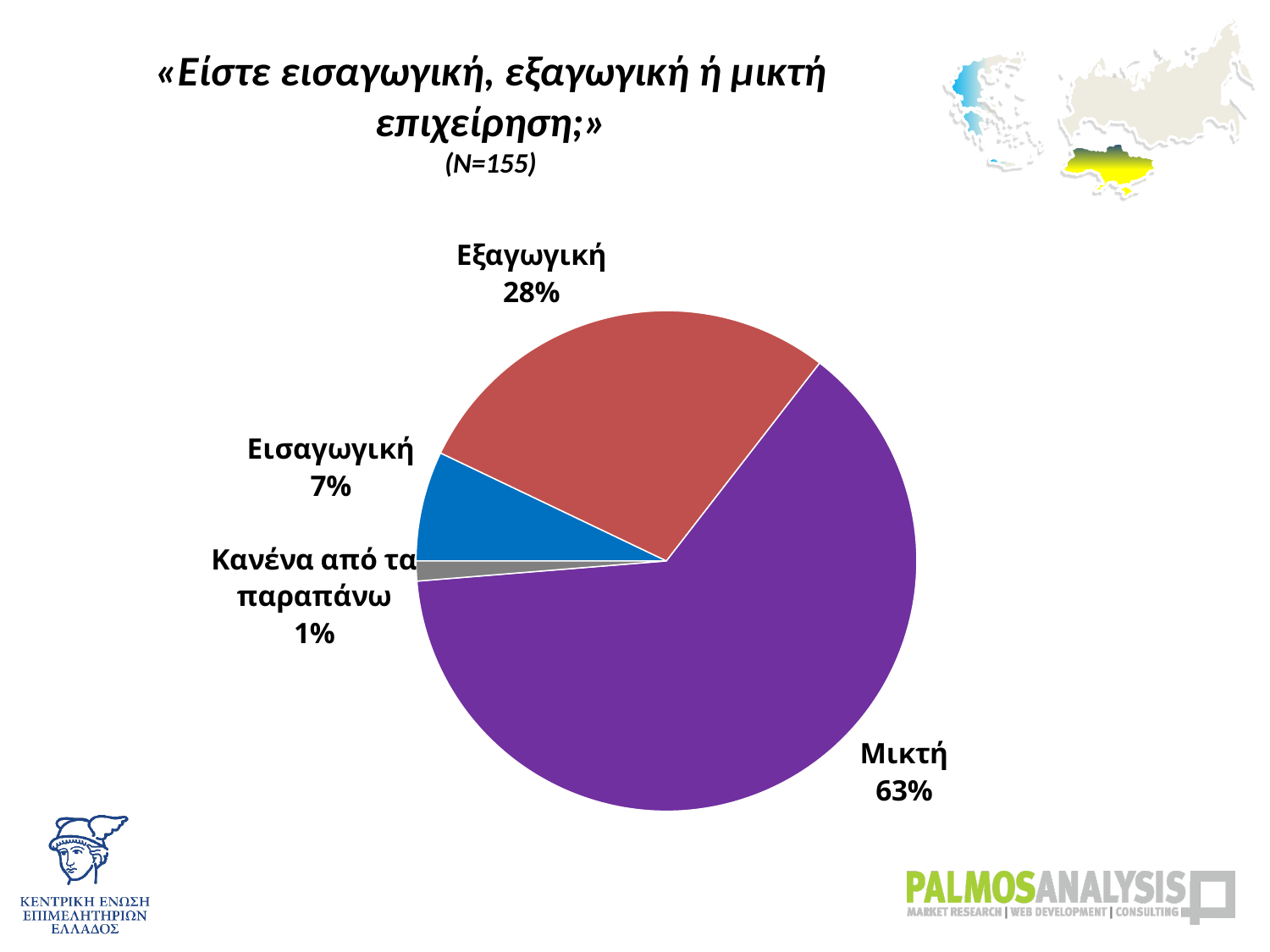
What percentage of the pie chart is labelled Εισαγωγική? 7% What is the difference in percentage points between Μικτή and Εξαγωγική? 35 What is the sample size (N) stated under the chart title? N=155 Which category has the smallest slice of the pie chart? Κανένα από τα παραπάνω What type of chart is shown on the slide? Pie chart What percentage of the pie chart is labelled Μικτή? 63% What percentage of the pie chart is labelled Εξαγωγική? 28% Which category has the largest slice of the pie chart? Μικτή What percentage of the pie chart is labelled Κανένα από τα παραπάνω? 1% Which is larger, the slice for Εισαγωγική or the slice for Εξαγωγική? Εξαγωγική What is the difference in percentage points between Εξαγωγική and Εισαγωγική? 21 How many slices does the pie chart have? 4